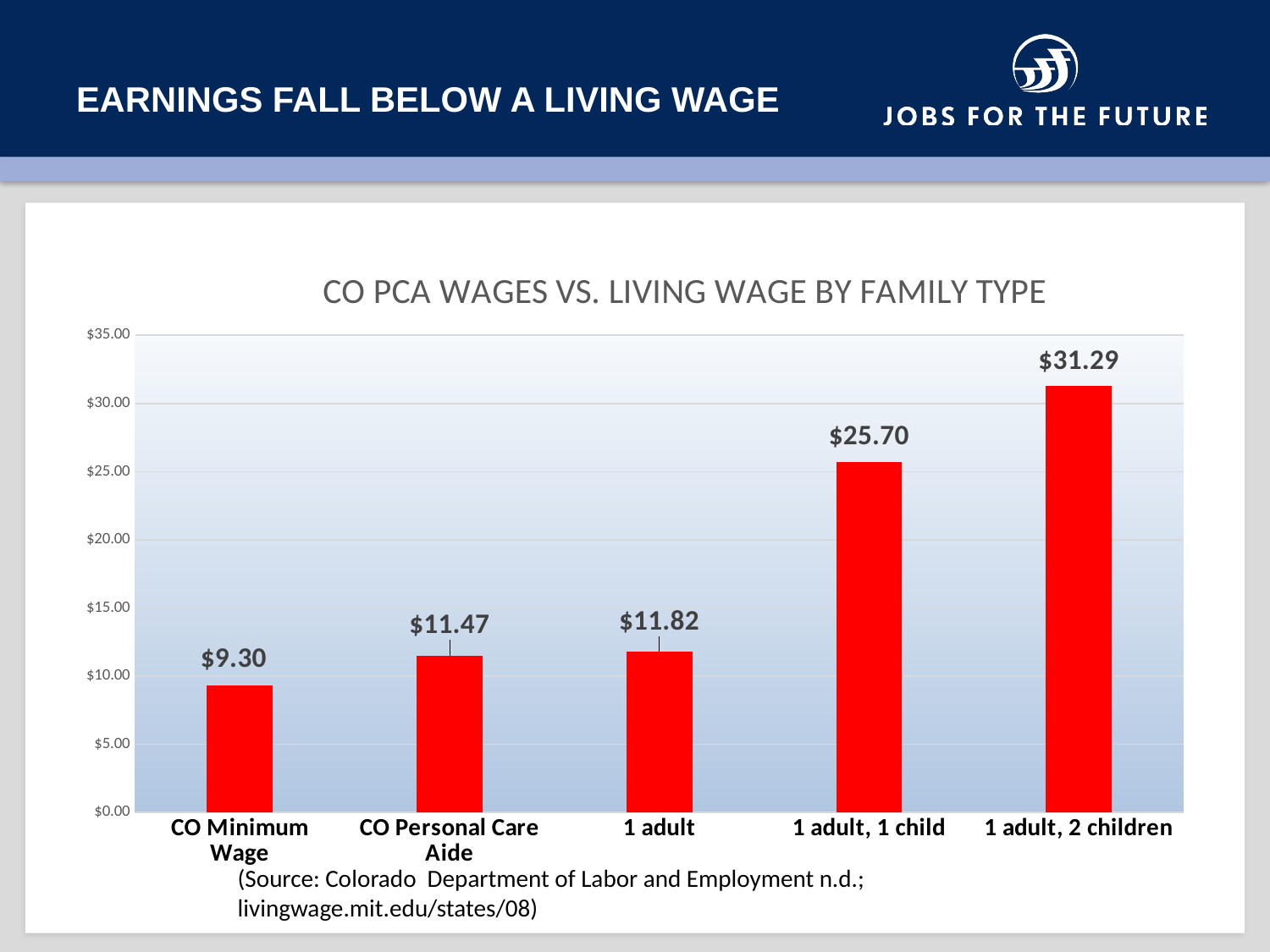
What is the value for CO Personal Care Aide? $11.47 What is the title of the chart? CO PCA WAGES VS. LIVING WAGE BY FAMILY TYPE What kind of chart is shown? bar chart What is the difference between the values for 1 adult, 2 children and CO Personal Care Aide? $19.82 Which category has the highest value? 1 adult, 2 children Which category has the lowest value? CO Minimum Wage Is the value for 1 adult, 1 child greater or less than $20.00? greater What is the value for 1 adult, 2 children? $31.29 What is the value for CO Minimum Wage? $9.30 What is the value for 1 adult, 1 child? $25.70 How many categories are shown on the x axis? 5 Which is larger, the value for 1 adult or the value for CO Personal Care Aide? 1 adult